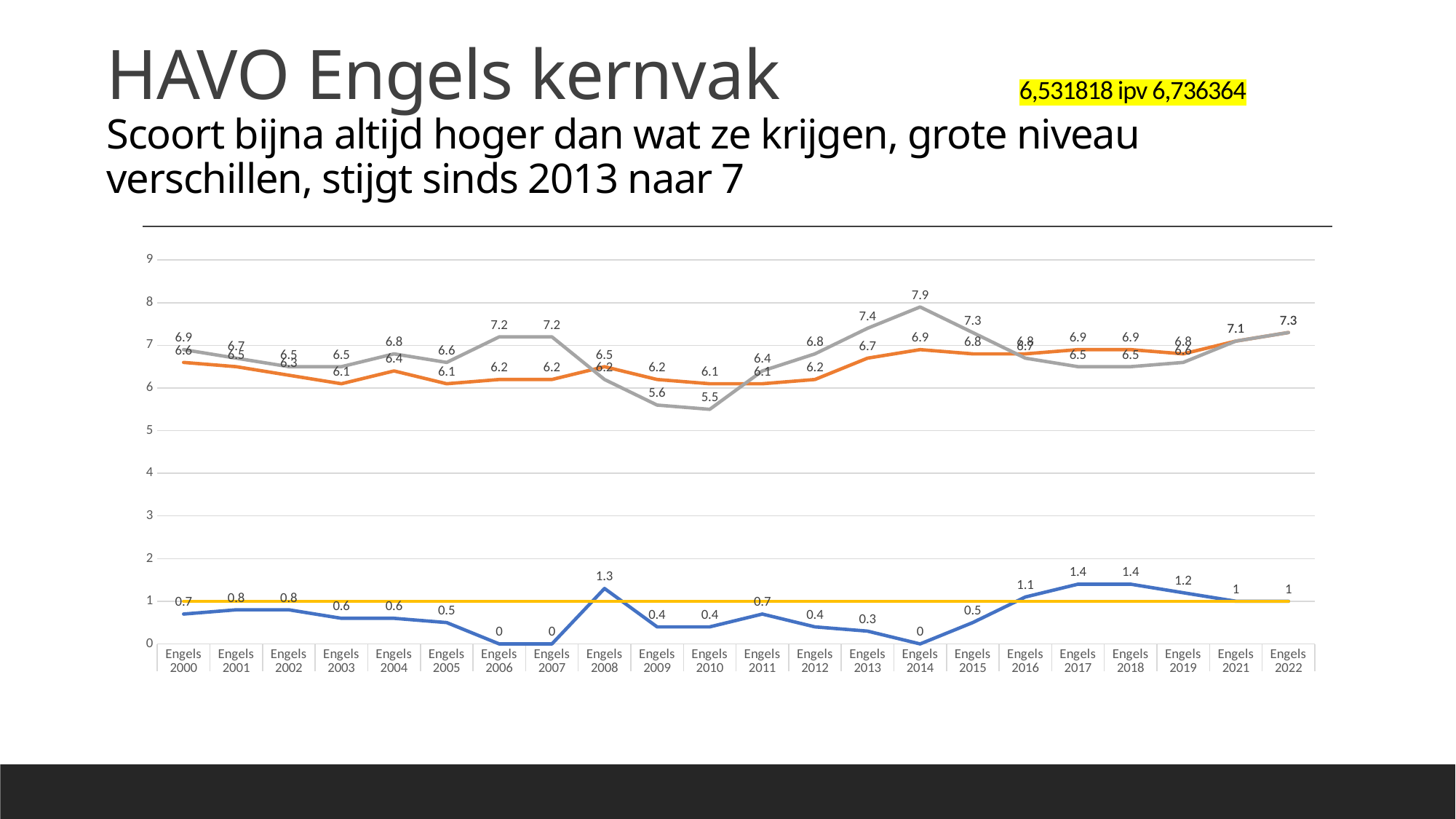
At Engels 2010, which is larger: the grey line or the orange line? the orange line What is the value of the orange line at Engels 2003? 6.1 What is the difference between the grey line and the orange line at Engels 2014? 1 What kind of chart is shown on the slide? line chart What is the value of the blue line at Engels 2008? 1.3 At which category does the grey line reach its lowest value? Engels 2010 What is the value of the grey line at Engels 2014? 7.9 How many categories are shown along the x axis of the chart? 22 What is the value of the grey line at Engels 2022? 7.3 At which category does the grey line reach its highest value? Engels 2014 What constant value does the yellow horizontal line sit at? 1 Is the value of the grey line at Engels 2014 greater or less than 7? greater